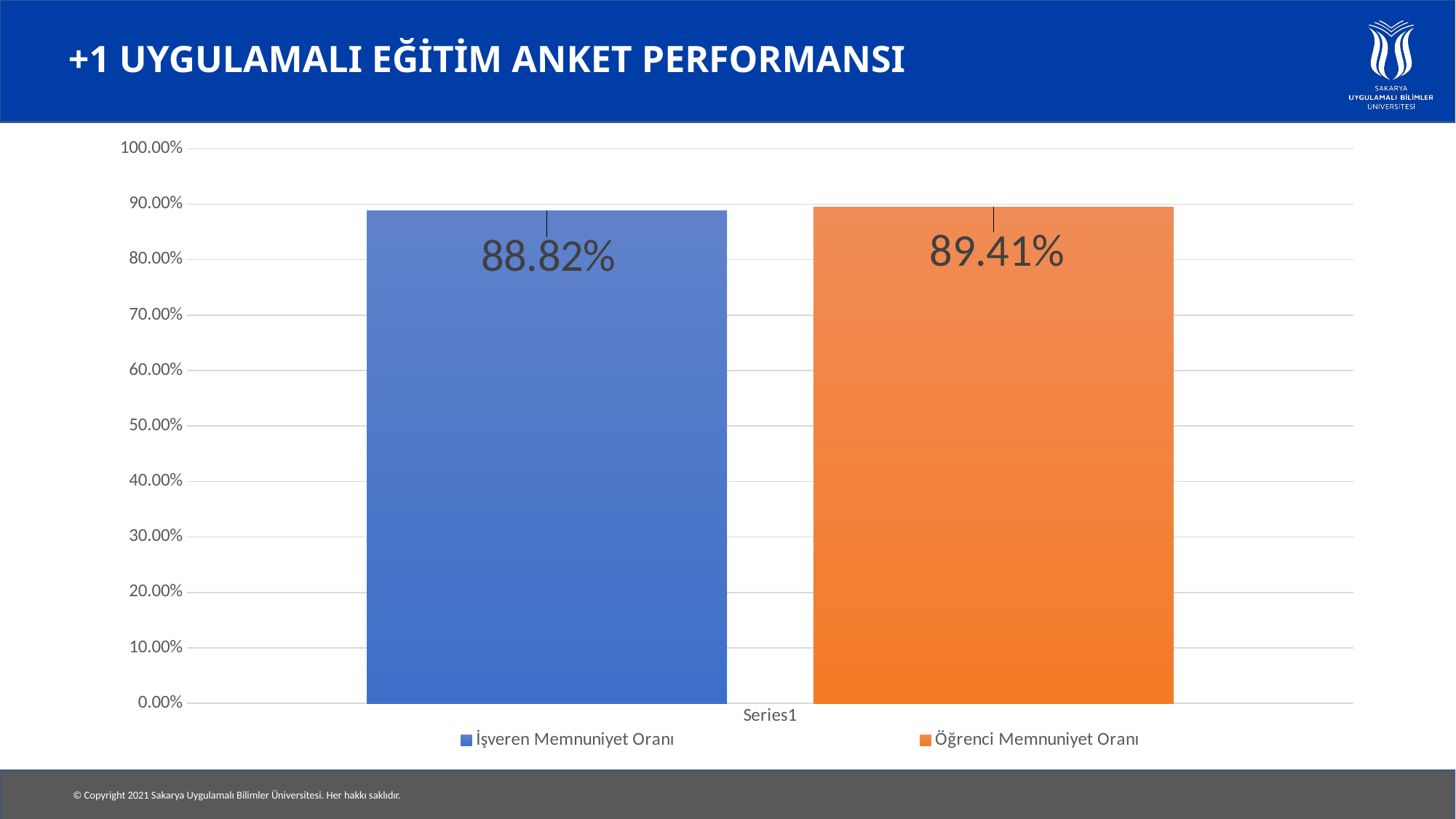
Which series has the higher value, İşveren Memnuniyet Oranı or Öğrenci Memnuniyet Oranı? Öğrenci Memnuniyet Oranı Which series has the lowest value on the chart? İşveren Memnuniyet Oranı What kind of chart is shown on the slide? Bar chart How many series does the legend list? 2 How many bars are plotted on the chart? 2 Is the value for Öğrenci Memnuniyet Oranı greater or less than 80.00%? greater What colour is the bar for Öğrenci Memnuniyet Oranı? Orange What is the value for İşveren Memnuniyet Oranı? 88.82% What is the value for Öğrenci Memnuniyet Oranı? 89.41% Is the value for İşveren Memnuniyet Oranı greater or less than 90.00%? less What is the difference between the Öğrenci Memnuniyet Oranı and İşveren Memnuniyet Oranı values? 0.59% Which series has the highest value on the chart? Öğrenci Memnuniyet Oranı